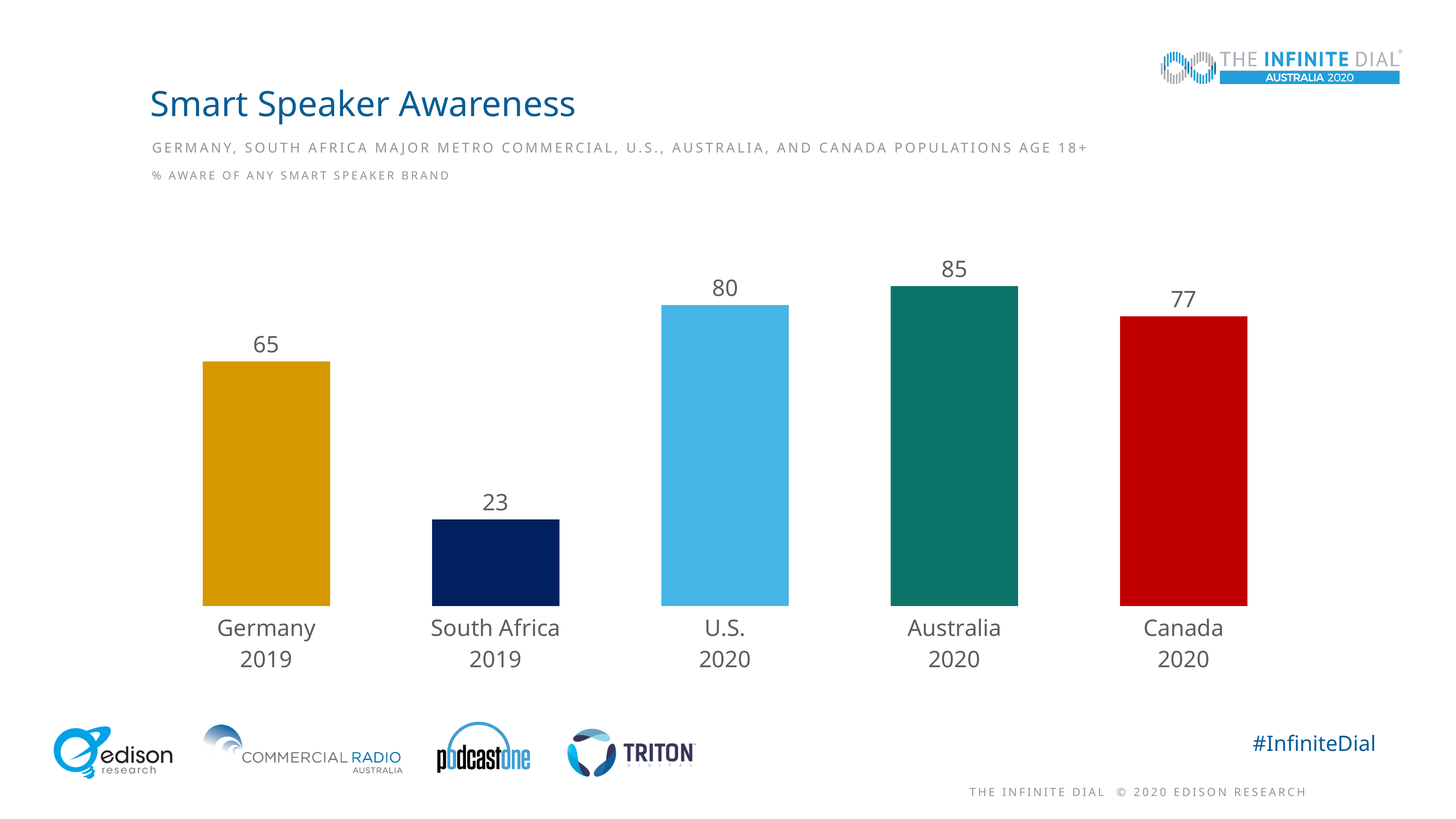
How many categories are shown in the chart? 5 What is the difference between the values for Australia 2020 and Canada 2020? 8 What is the value for South Africa 2019? 23 Which category has the highest value? Australia 2020 What is the title of the chart? Smart Speaker Awareness What is the value for Germany 2019? 65 Which category has the lowest value? South Africa 2019 What kind of chart is shown on the slide? Bar chart Which is larger, the value for U.S. 2020 or the value for Canada 2020? U.S. 2020 What is the value for Canada 2020? 77 What is the difference between the values for Germany 2019 and South Africa 2019? 42 What is the value for U.S. 2020? 80